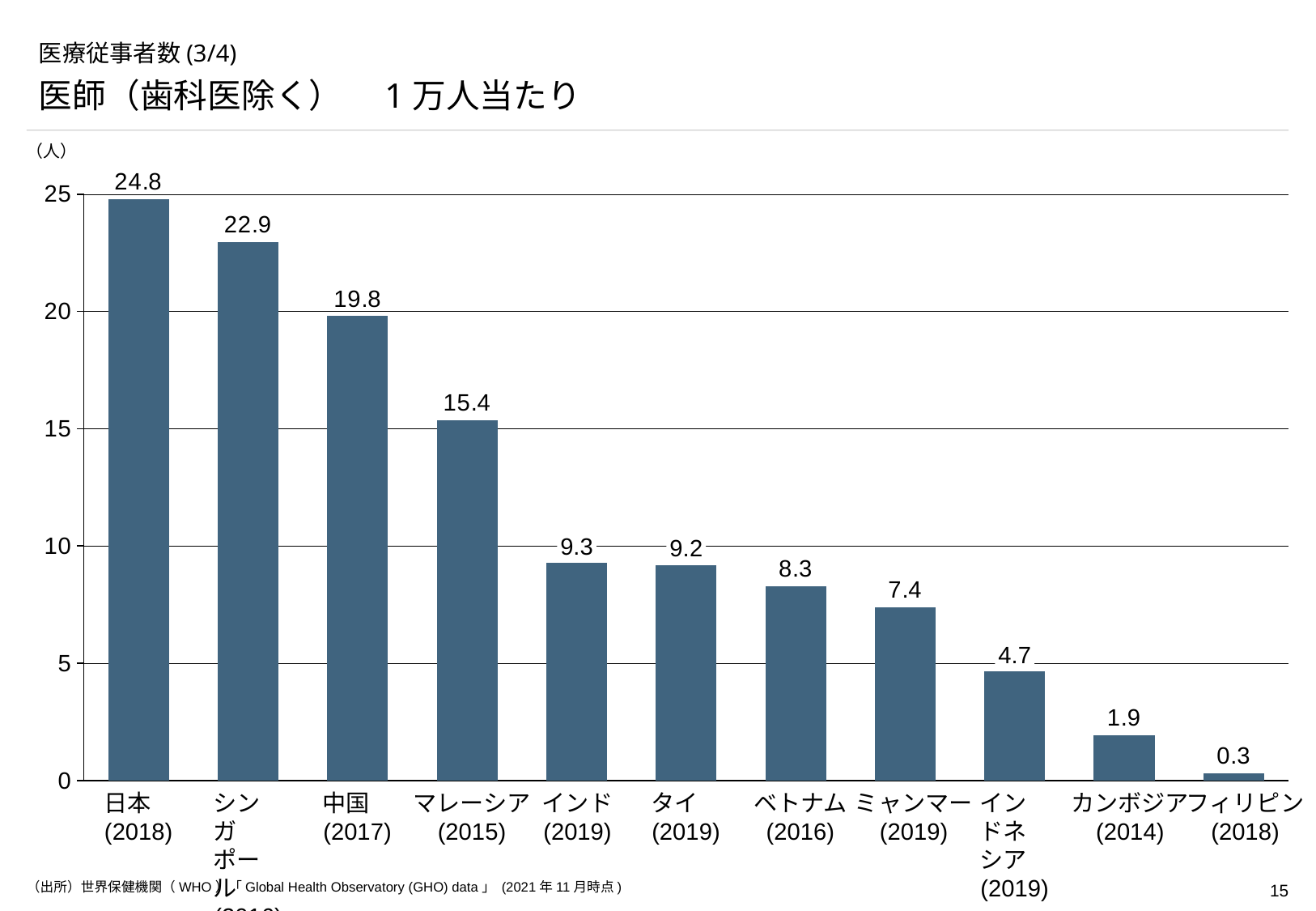
What is the difference between the values for マレーシア and インドネシア? 10.7 What is the value for 日本 (2018)? 24.8 What is the difference between the values for 日本 and シンガポール? 1.9 Which country has the lowest value? フィリピン How many countries are shown in the chart? 11 Which country has the highest value? 日本 Which is larger, the value for ミャンマー or the value for インドネシア? ミャンマー What is the value for カンボジア (2014)? 1.9 Do the values rise or fall from left to right across the chart? fall What is the value for ベトナム (2016)? 8.3 What kind of chart is this? bar chart What is the value for 中国 (2017)? 19.8